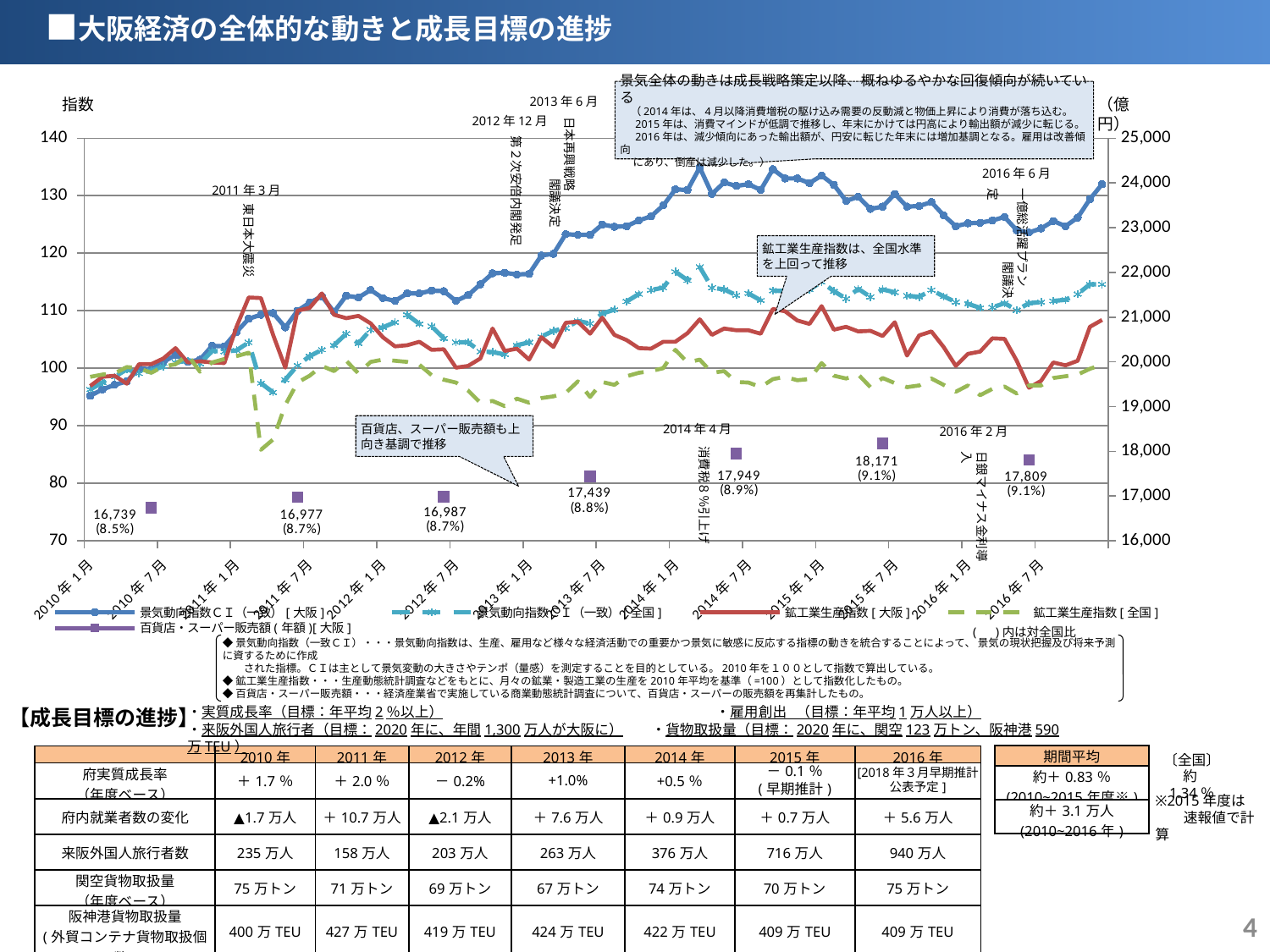
What percentage share of the national total is shown in parentheses for the 2010 百貨店・スーパー販売額 value? 8.5% In which year is the 百貨店・スーパー販売額 (年額) [大阪] value lowest? 2010 By how much did the 百貨店・スーパー販売額 value fall from 2015 to 2016? 362 What kind of chart is shown on the slide? line chart What is the 百貨店・スーパー販売額 (年額) [大阪] value plotted for 2010? 16,739 Is the 景気動向指数CI（一致）[大阪] value at 2016年7月 greater or less than 120? greater What is the difference between the 百貨店・スーパー販売額 values for 2015 and 2010? 1,432 What is the 百貨店・スーパー販売額 (年額) [大阪] value plotted for 2015? 18,171 How many series does the chart legend list? 5 In which year is the 百貨店・スーパー販売額 (年額) [大阪] value highest? 2015 How many 百貨店・スーパー販売額 (年額) data points are labelled on the chart? 7 Which year has the larger 百貨店・スーパー販売額 value, 2013 or 2014? 2014